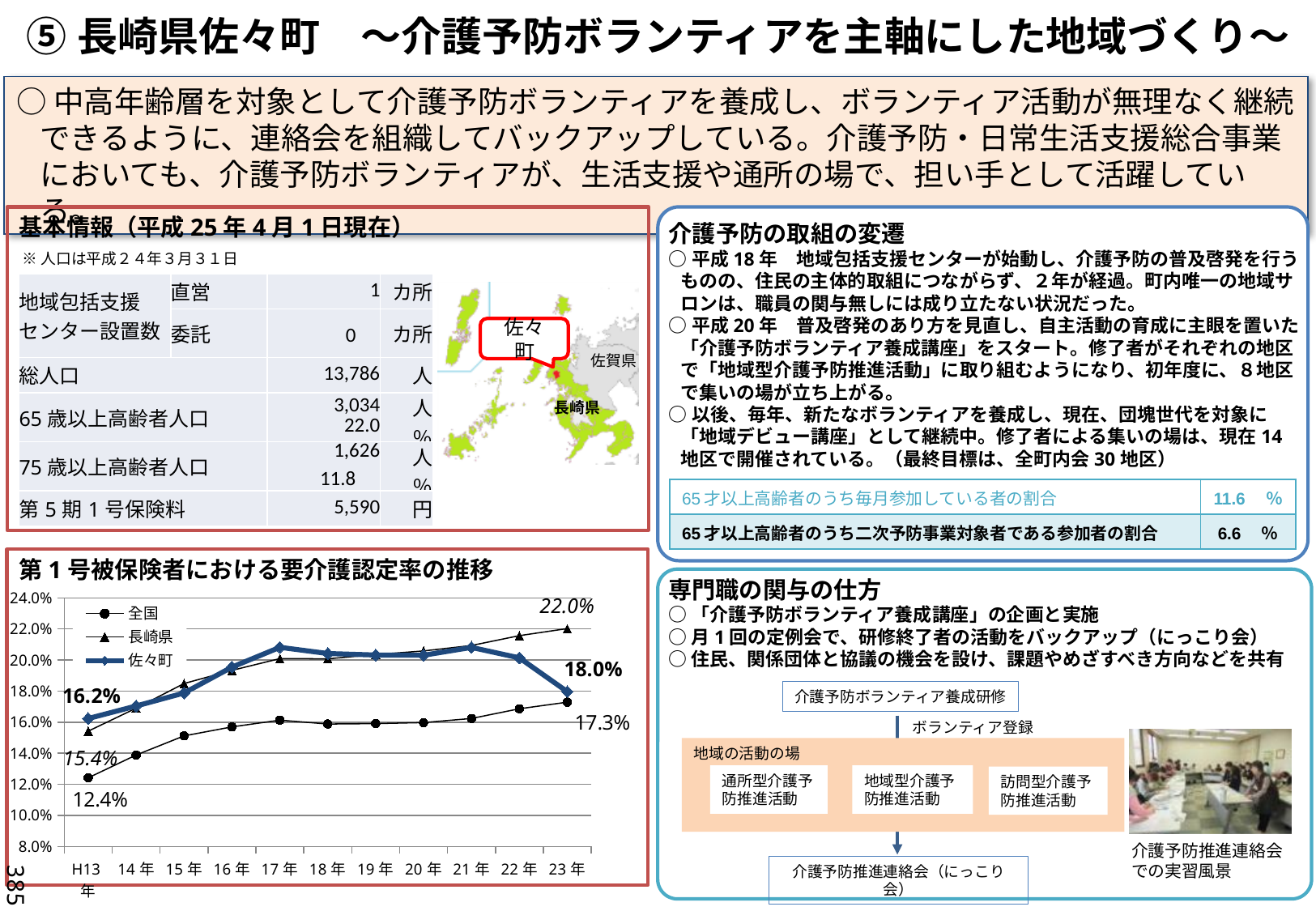
In the line chart 第1号被保険者における要介護認定率の推移, is the value for 佐々町 at 17年 greater or less than 20.0%? greater How many series does the legend of the line chart 第1号被保険者における要介護認定率の推移 list? 3 In the line chart 第1号被保険者における要介護認定率の推移, which series has the lowest value at H13年? 全国 How many years are plotted on the x axis of the chart 第1号被保険者における要介護認定率の推移? 11 In the line chart 第1号被保険者における要介護認定率の推移, what is the value for 佐々町 at H13年? 16.2% In the line chart 第1号被保険者における要介護認定率の推移, what is the value for 全国 at H13年? 12.4% In the line chart 第1号被保険者における要介護認定率の推移, what is the value for 長崎県 at 23年? 22.0% In the line chart 第1号被保険者における要介護認定率の推移, what is the value for 佐々町 at 23年? 18.0% In the line chart 第1号被保険者における要介護認定率の推移, what is the value for 全国 at 23年? 17.3% What kind of chart is 第1号被保険者における要介護認定率の推移? line chart In the line chart 第1号被保険者における要介護認定率の推移, which series has the highest value at 23年? 長崎県 In the line chart 第1号被保険者における要介護認定率の推移, by how much did the 佐々町 value change from H13年 to 23年? 1.8 percentage points